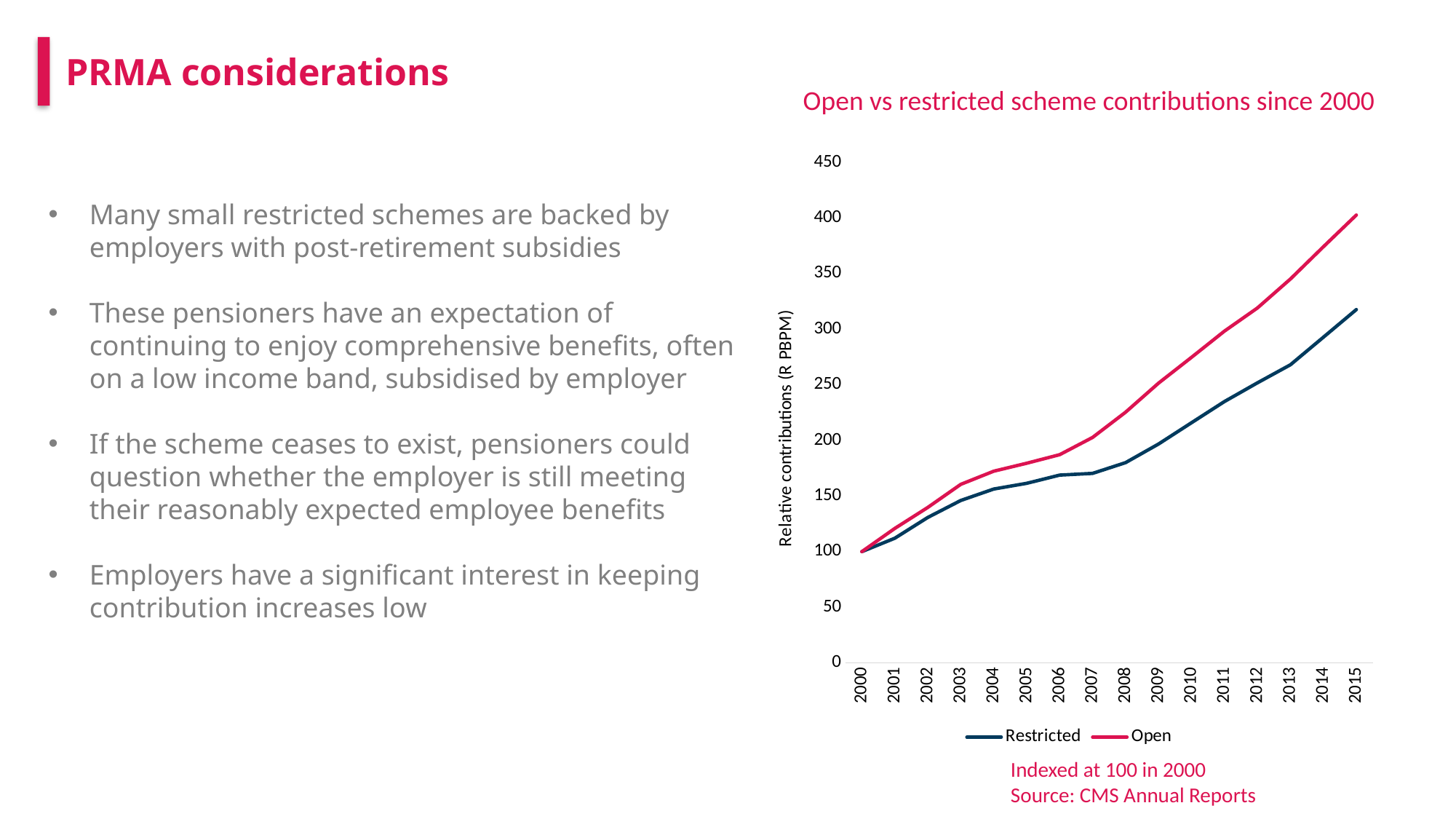
What is the title of the chart? Open vs restricted scheme contributions since 2000 Is the value for Restricted in 2015 greater or less than 300? greater Do the values for the Open series rise or fall from 2000 to 2015? rise What is the value of both series in 2000? 100 What are the two series named in the chart legend? Restricted and Open Is the value for Restricted in 2008 greater or less than 200? less In which year does the Open series reach its highest value? 2015 What kind of chart is shown on the slide? line chart How many series does the chart legend list? 2 Is the value for Open in 2015 greater or less than 350? greater Which series has the higher value in 2015, Restricted or Open? Open How many years are shown on the x axis of the chart? 16